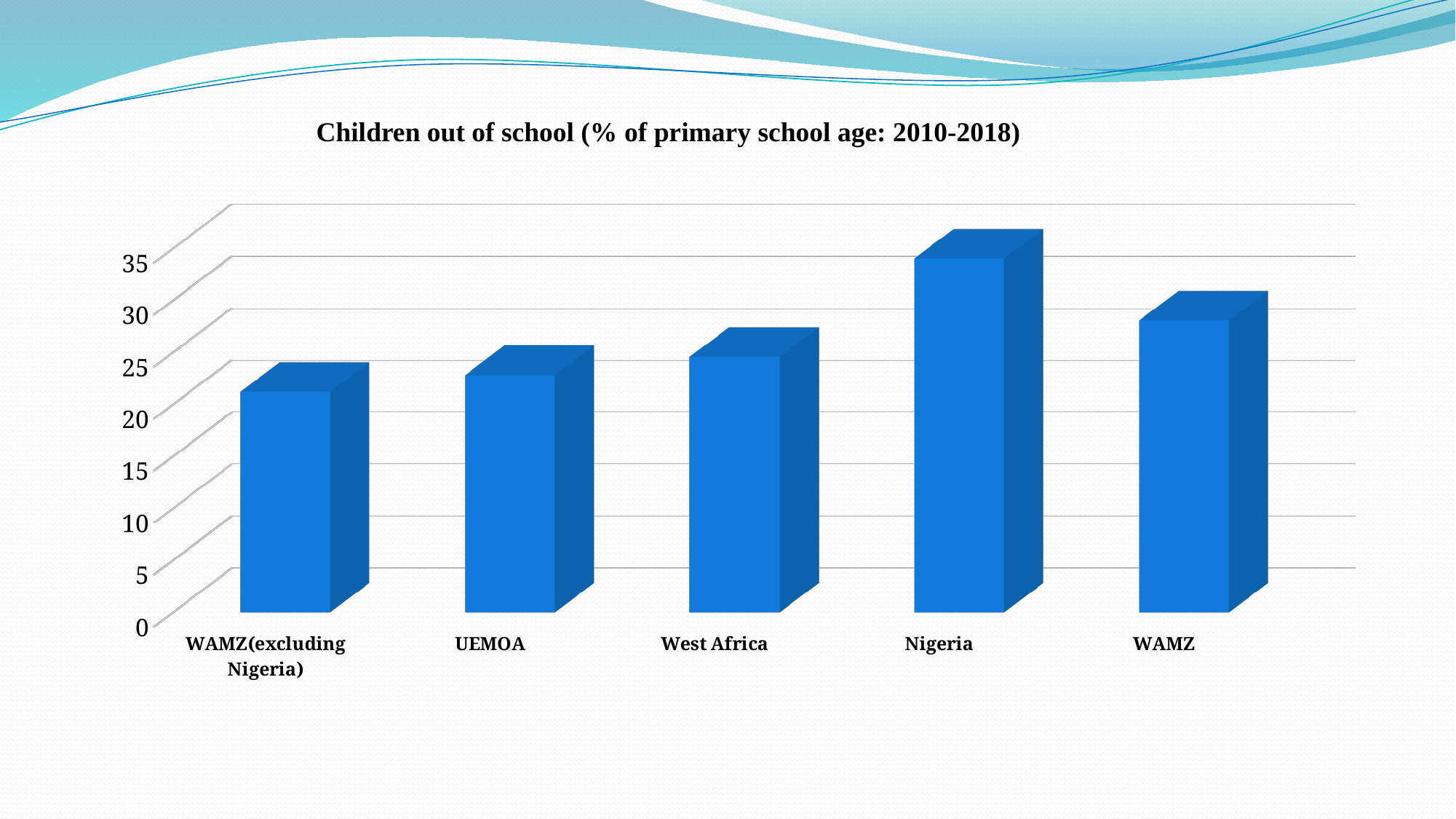
Which has a larger value, Nigeria or WAMZ? Nigeria Which category has the lowest value in the chart? WAMZ(excluding Nigeria) Which has a larger value, West Africa or WAMZ? WAMZ What is the title of the chart? Children out of school (% of primary school age: 2010-2018) What kind of chart is shown on the slide? Bar chart Is the value for Nigeria greater or less than 30? greater Is the value for WAMZ(excluding Nigeria) greater or less than 25? less Is the value for UEMOA greater or less than 20? greater How many categories are shown on the x axis of the chart? 5 Which category has the highest value in the chart? Nigeria